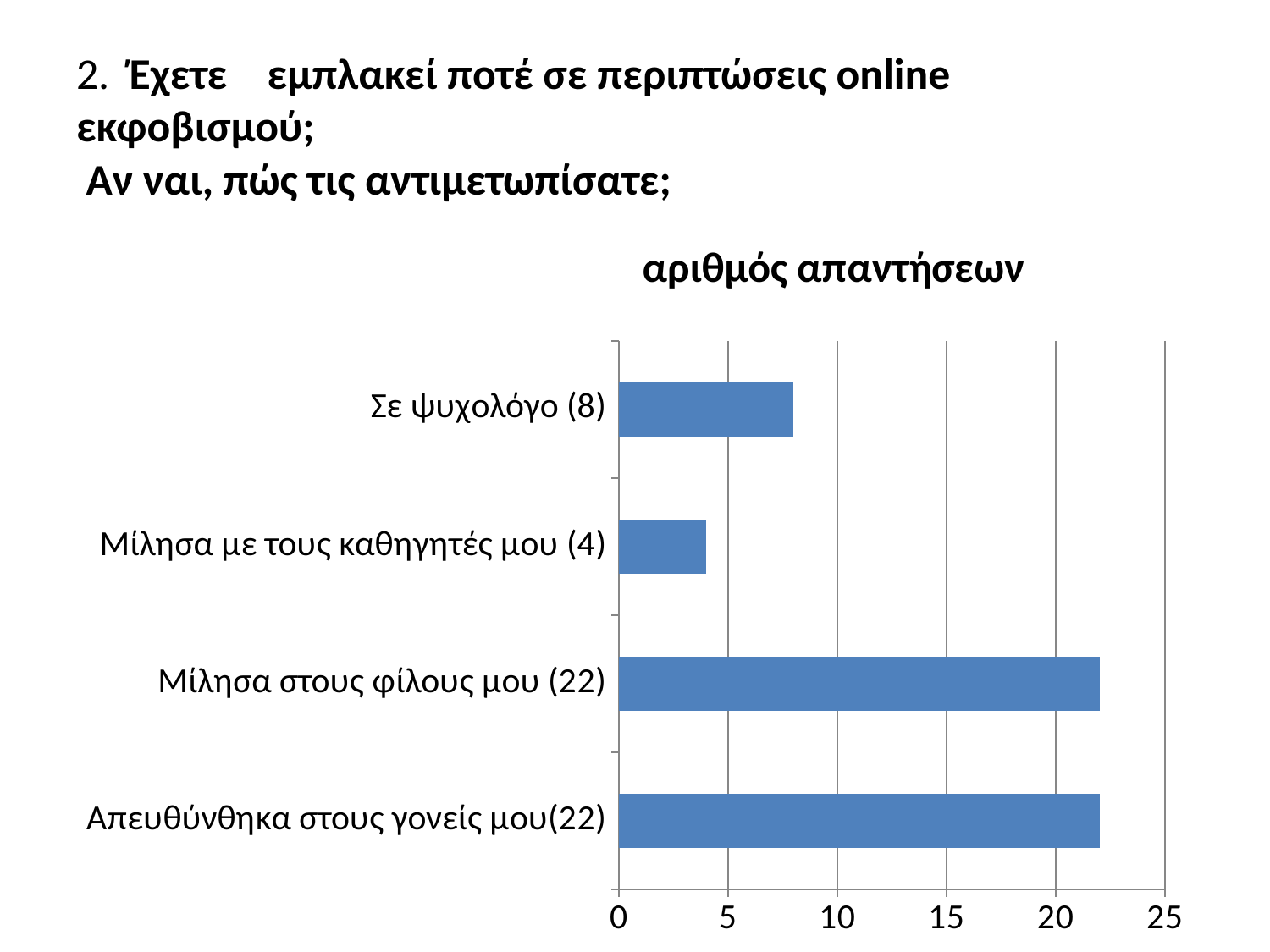
Is the value for "Σε ψυχολόγο" greater or less than 10? less What is the difference between the values for "Σε ψυχολόγο" and "Μίλησα με τους καθηγητές μου"? 4 What is the value for "Μίλησα με τους καθηγητές μου"? 4 What is the value for "Μίλησα στους φίλους μου"? 22 What is the value for "Σε ψυχολόγο"? 8 Which category has the lowest value? Μίλησα με τους καθηγητές μου What is the difference between the values for "Μίλησα στους φίλους μου" and "Σε ψυχολόγο"? 14 Which is larger, the value for "Σε ψυχολόγο" or the value for "Μίλησα με τους καθηγητές μου"? Σε ψυχολόγο What is the title of the chart? αριθμός απαντήσεων How many categories does the chart show? 4 What type of chart is shown on the slide? bar chart What is the value for "Απευθύνθηκα στους γονείς μου"? 22